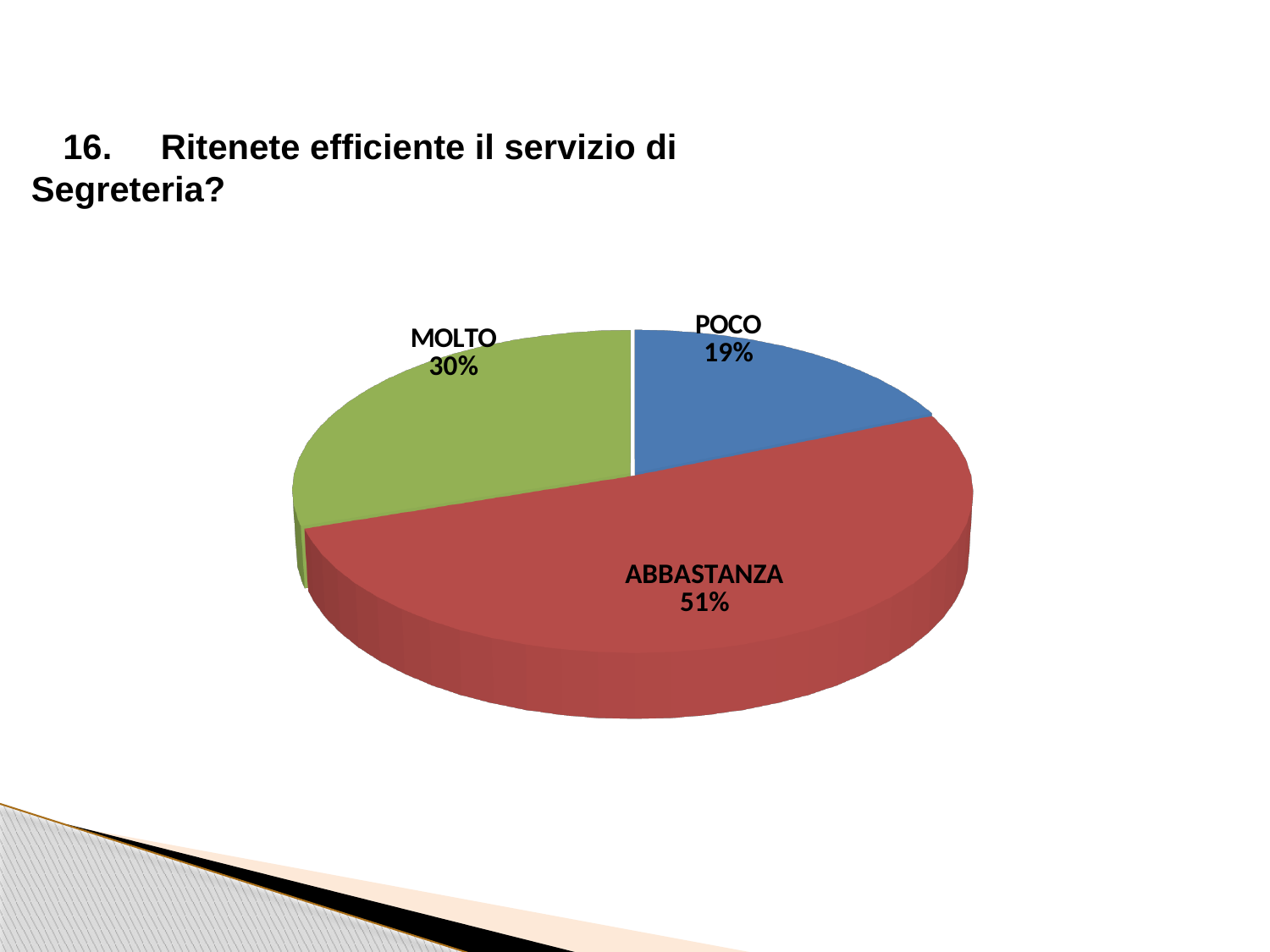
What percentage of respondents answered POCO? 19% What percentage of respondents answered ABBASTANZA? 51% Which is larger, the share for MOLTO or the share for POCO? MOLTO What colour is the ABBASTANZA slice? Red How many slices does the pie chart have? 3 What is the difference in percentage points between MOLTO and POCO? 11 What percentage of respondents answered MOLTO? 30% What kind of chart is shown on the slide? Pie chart Which response has the smallest share of the pie? POCO What question does the chart on the slide refer to? 16. Ritenete efficiente il servizio di Segreteria? What is the difference in percentage points between ABBASTANZA and MOLTO? 21 Which response has the largest share of the pie? ABBASTANZA